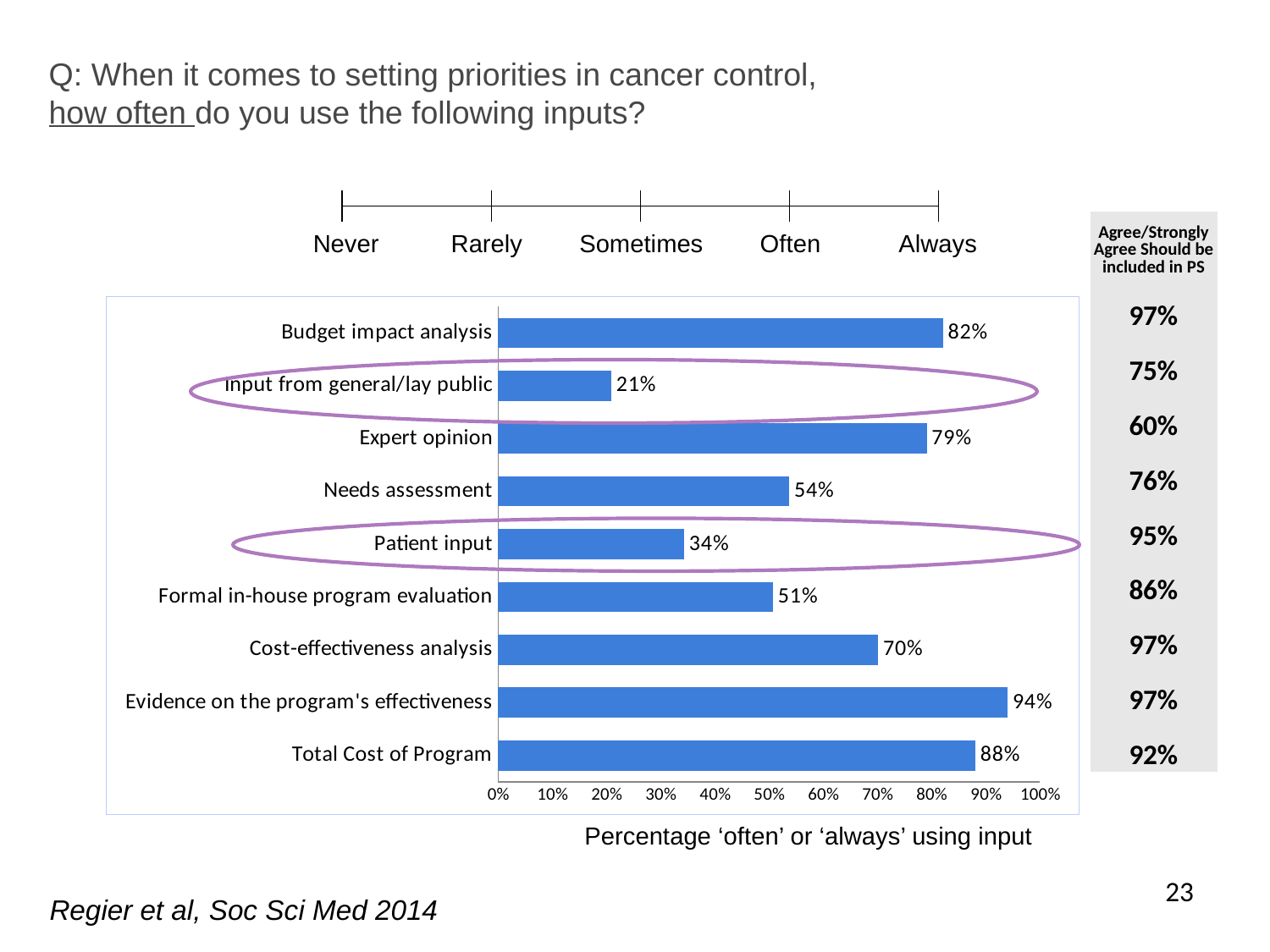
What is the value shown for Patient input? 34% What percentage of respondents report 'often' or 'always' using Budget impact analysis? 82% What is the value shown for Input from general/lay public? 21% How many inputs (categories) are plotted in the bar chart? 9 Which input has the highest percentage of 'often' or 'always' use? Evidence on the program's effectiveness Is the value for Formal in-house program evaluation greater or less than 60%? less What kind of chart is used to show the percentage 'often' or 'always' using each input? bar chart What is the difference between the values for Total Cost of Program and Cost-effectiveness analysis? 18% What is the label of the horizontal axis below the chart? Percentage 'often' or 'always' using input Which input has the lowest percentage of 'often' or 'always' use? Input from general/lay public Which is larger, the value for Expert opinion or the value for Needs assessment? Expert opinion What is the highest tick value shown on the horizontal axis? 100%